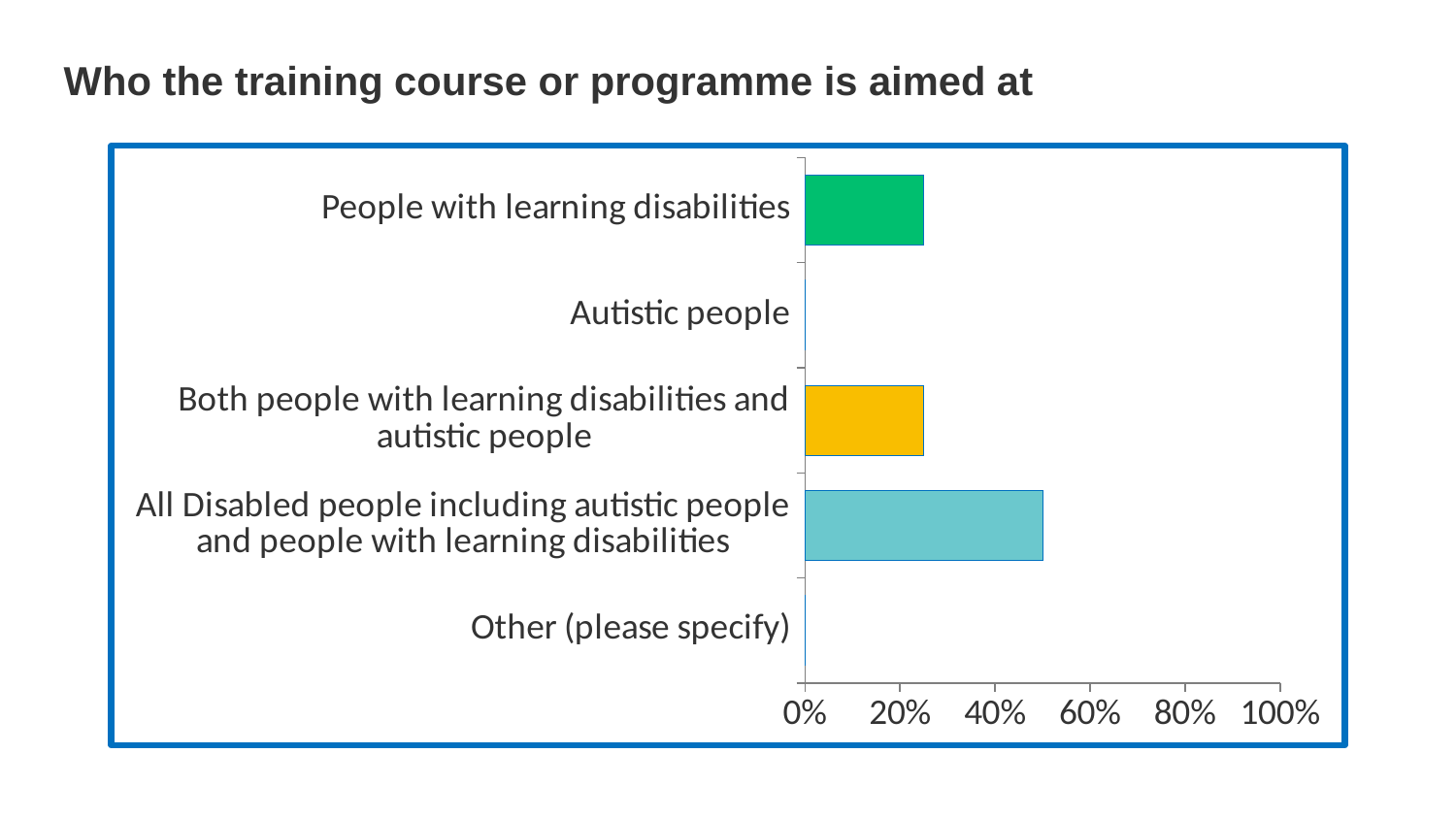
Is the value for 'All Disabled people including autistic people and people with learning disabilities' greater or less than 40%? greater Which category has the highest value? All Disabled people including autistic people and people with learning disabilities Which is larger: the value for 'People with learning disabilities' or the value for 'Autistic people'? People with learning disabilities How many categories show no bar at all? 2 What kind of chart is shown on the slide? bar chart Which is larger: the value for 'All Disabled people including autistic people and people with learning disabilities' or the value for 'Both people with learning disabilities and autistic people'? All Disabled people including autistic people and people with learning disabilities Is the value for 'People with learning disabilities' greater or less than 20%? greater Is the value for 'Both people with learning disabilities and autistic people' greater or less than 40%? less What is the title of the slide? Who the training course or programme is aimed at How many categories are shown on the chart? 5